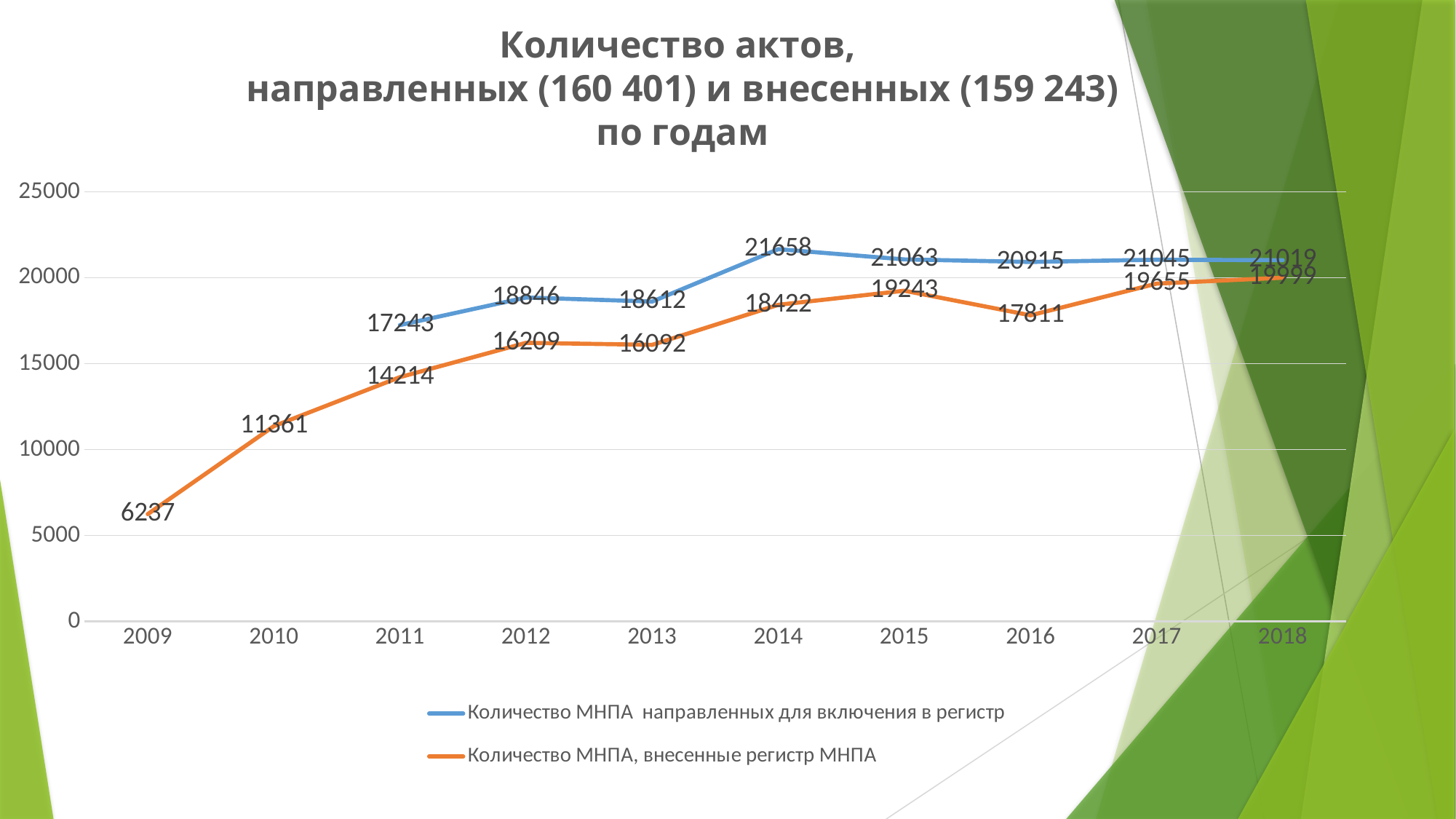
In which year is the series 'Количество МНПА, внесенные регистр МНПА' at its lowest value? 2009 What is the value of the series 'Количество МНПА, внесенные регистр МНПА' for 2009? 6237 What is the value of the series 'Количество МНПА, внесенные регистр МНПА' for 2018? 19999 Is the value of 'Количество МНПА, внесенные регистр МНПА' for 2010 greater or less than 10000? greater What kind of chart is shown on the slide? line chart Does the series 'Количество МНПА, внесенные регистр МНПА' rise or fall from 2009 to 2012? rise What is the value of the series 'Количество МНПА направленных для включения в регистр' for 2014? 21658 How many series does the legend list? 2 How many years are shown on the x axis? 10 In which year does the series 'Количество МНПА направленных для включения в регистр' reach its highest value? 2014 What is the difference between the two series' values in 2014? 3236 In 2016, which series has the larger value? Количество МНПА направленных для включения в регистр